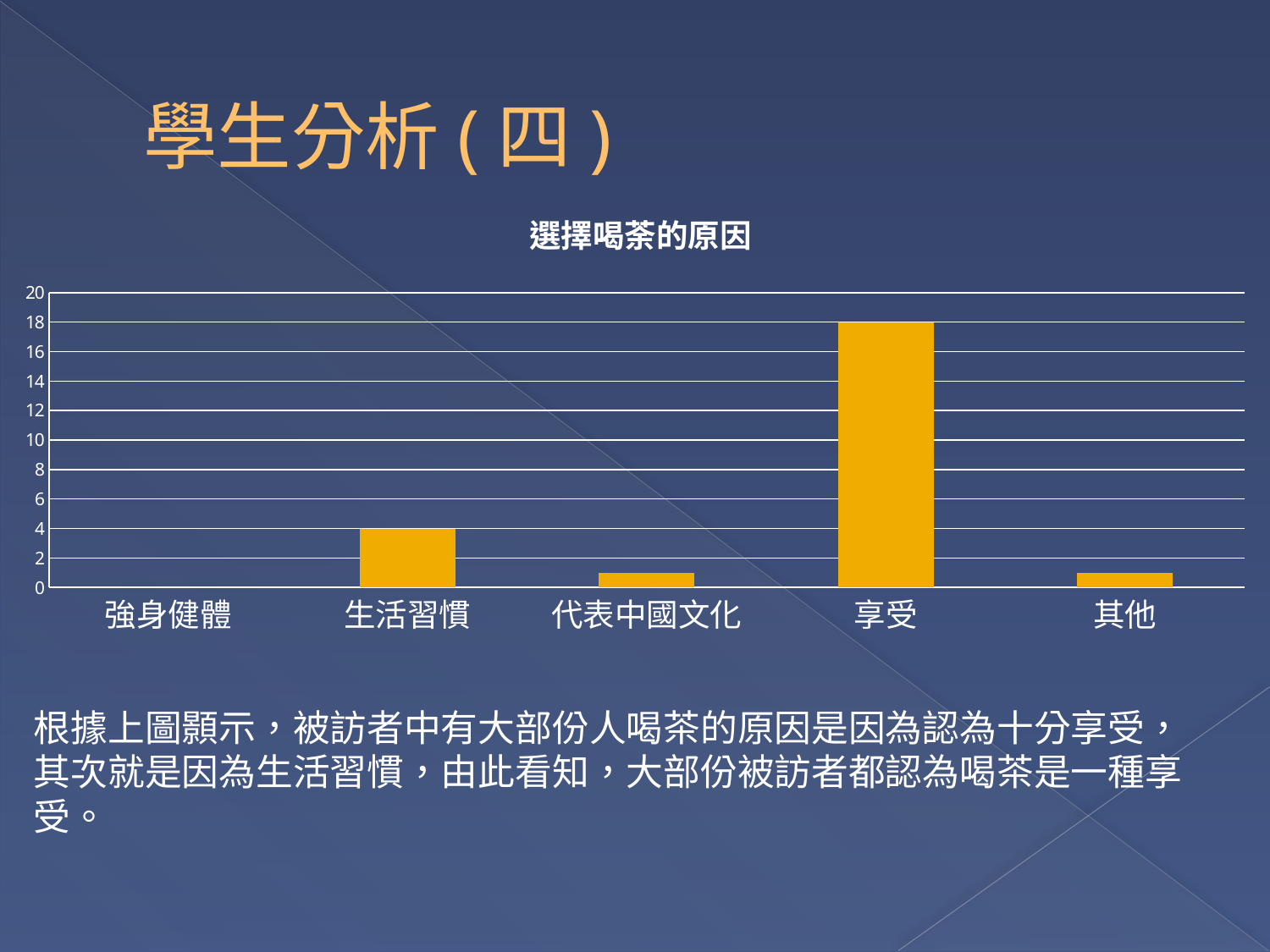
How many categories are shown on the x axis of the chart? 5 What is the title of the chart? 選擇喝茶的原因 Which category has the lowest value in the chart? 強身健體 What is the difference between the values for 享受 and 生活習慣? 14 Which is larger, the value for 生活習慣 or the value for 代表中國文化? 生活習慣 Is the value for 代表中國文化 greater or less than 2? less What kind of chart is shown on the slide? bar chart Is the value for 其他 greater or less than 2? less Which category has the highest value in the chart? 享受 What is the value for 享受? 18 What is the value for 生活習慣? 4 Is the value for 享受 greater or less than 10? greater